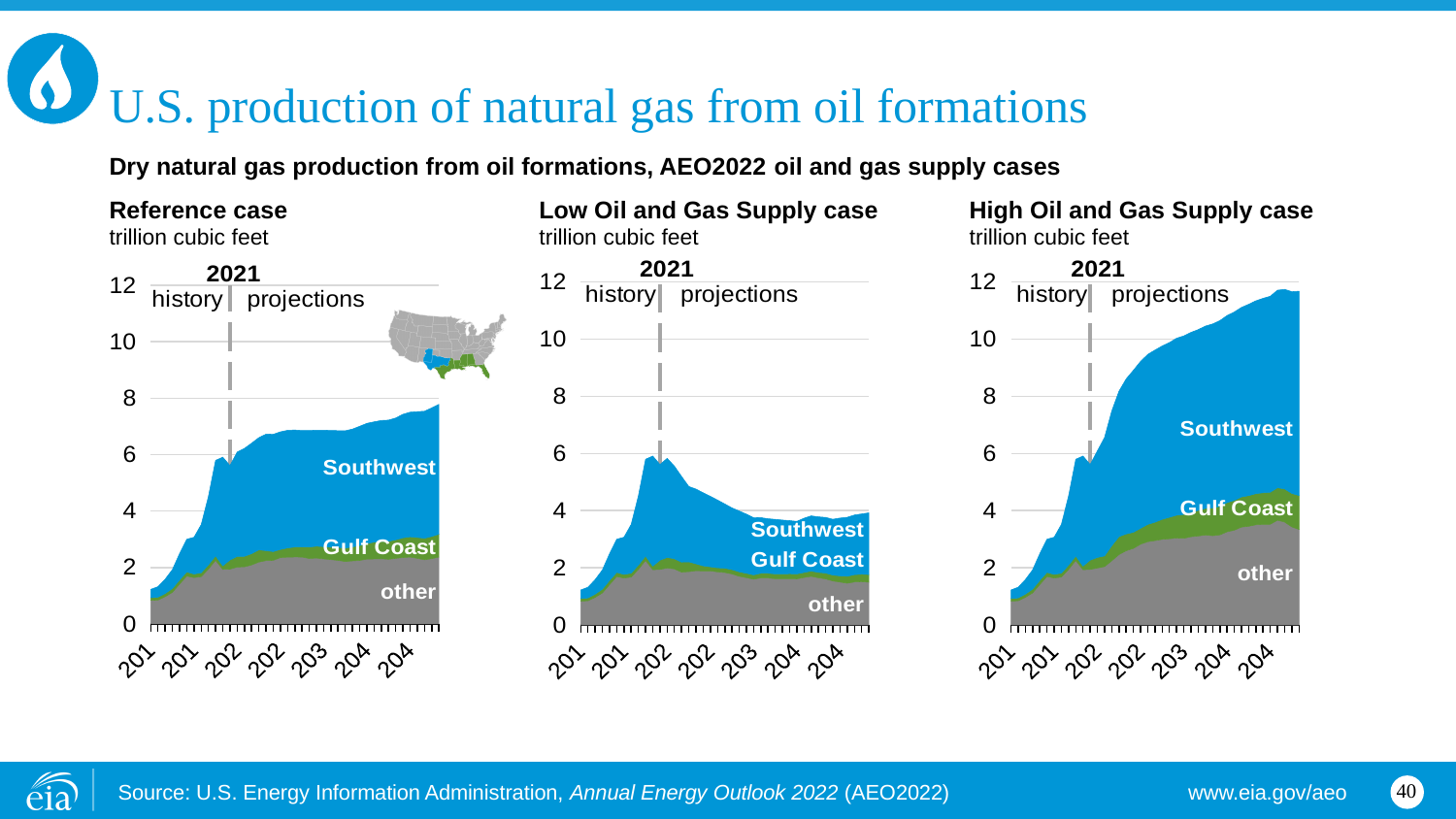
How many regions (series) are stacked in the High Oil and Gas Supply case chart? 3 In the High Oil and Gas Supply case chart, does total production rise or fall over the projection period? rise Which of the three cases shows the lowest total production at the end of the projection period? Low Oil and Gas Supply case What unit is used on the y axis of all three charts? trillion cubic feet In the High Oil and Gas Supply case chart, is the total production at the end of the projection period greater or less than 10 trillion cubic feet? greater What year does the dashed vertical line separating history from projections mark? 2021 In the Low Oil and Gas Supply case chart, does total production rise or fall after 2021? fall In the Reference case chart, which region forms the top (largest) layer of the stack in the projection years? Southwest Which of the three cases shows the highest total production at the end of the projection period? High Oil and Gas Supply case What kind of chart is the Reference case chart? stacked area chart In the Low Oil and Gas Supply case chart, is the total production at the end of the projection period greater or less than 6 trillion cubic feet? less In the Reference case chart, is the total production at the end of the projection period greater or less than 6 trillion cubic feet? greater